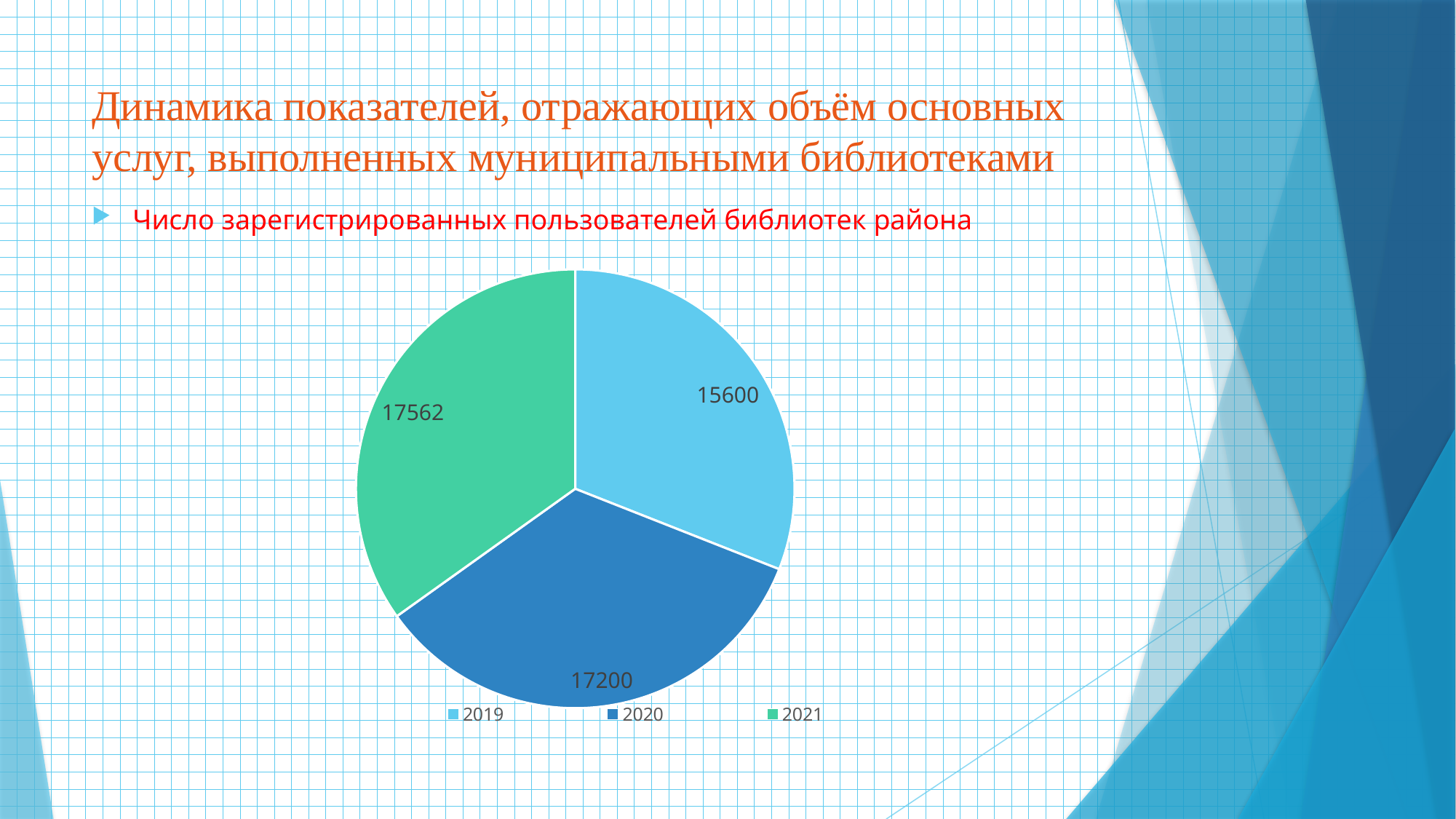
How many entries does the legend list? 3 What is the value for 2019 in the pie chart? 15600 What is the difference between the values for 2020 and 2019? 1600 What type of chart is shown on the slide? Pie chart What colour is the slice for 2021 in the pie chart? Green Which year has the largest slice in the pie chart? 2021 What is the value for 2020 in the pie chart? 17200 Which is larger, the value for 2019 or the value for 2020? 2020 What is the difference between the values for 2021 and 2020? 362 How many slices does the pie chart have? 3 What is the value for 2021 in the pie chart? 17562 Which year has the smallest slice in the pie chart? 2019